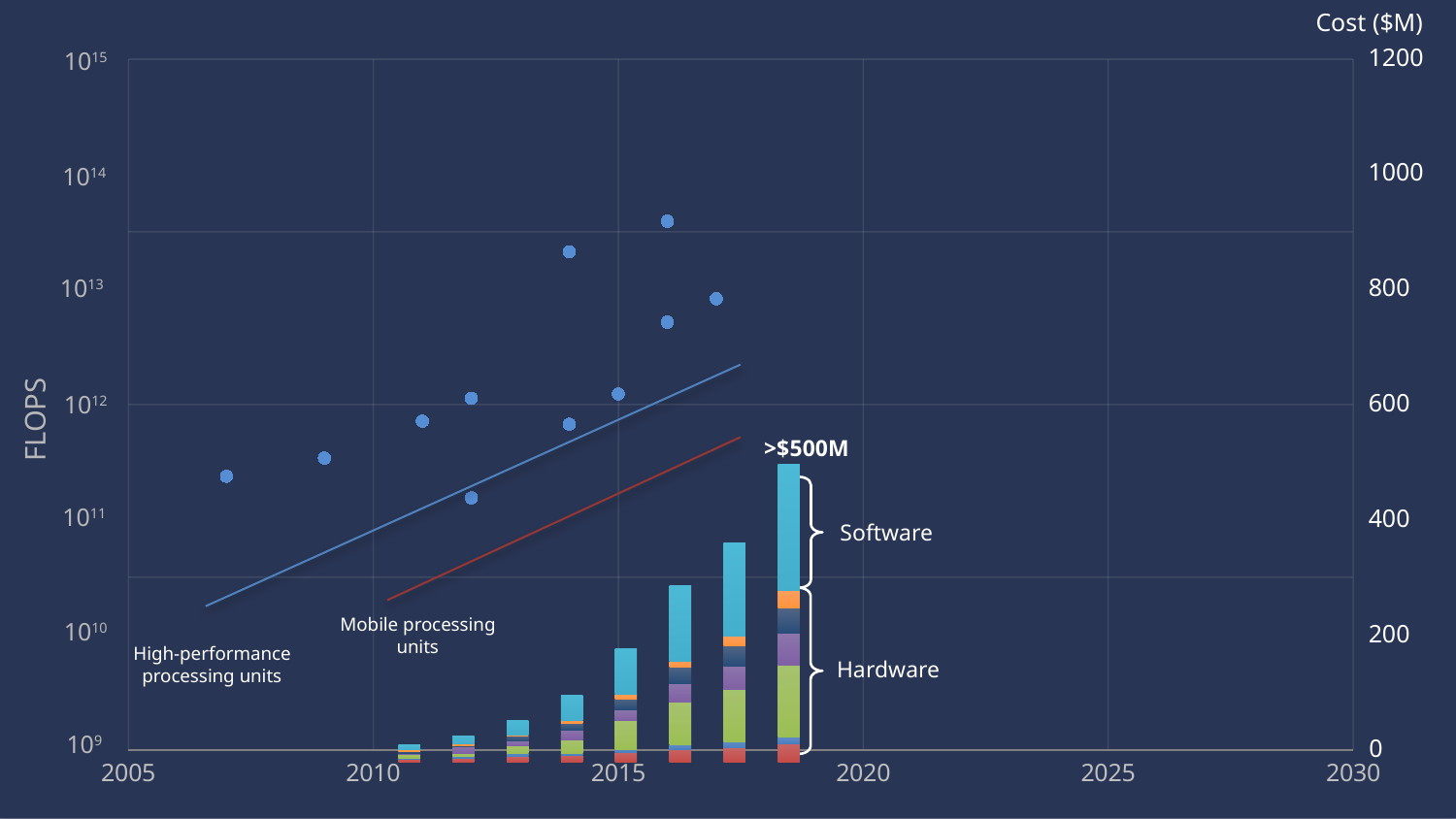
Is the highest scatter point on the FLOPS axis greater or less than 10^13? greater Which trend line sits higher on the FLOPS axis, the one for high-performance processing units or the one for mobile processing units? High-performance processing units Do the stacked cost bars rise or fall as the years increase along the x axis? Rise Is the total cost of the tallest stacked bar greater or less than 400 on the Cost ($M) axis? greater What kinds of chart are combined on this slide? A scatter plot with trend lines and a stacked bar chart Is the total cost of the tallest stacked bar greater or less than 600 on the Cost ($M) axis? less What is the label of the left vertical axis? FLOPS What is the label of the right vertical axis? Cost ($M)